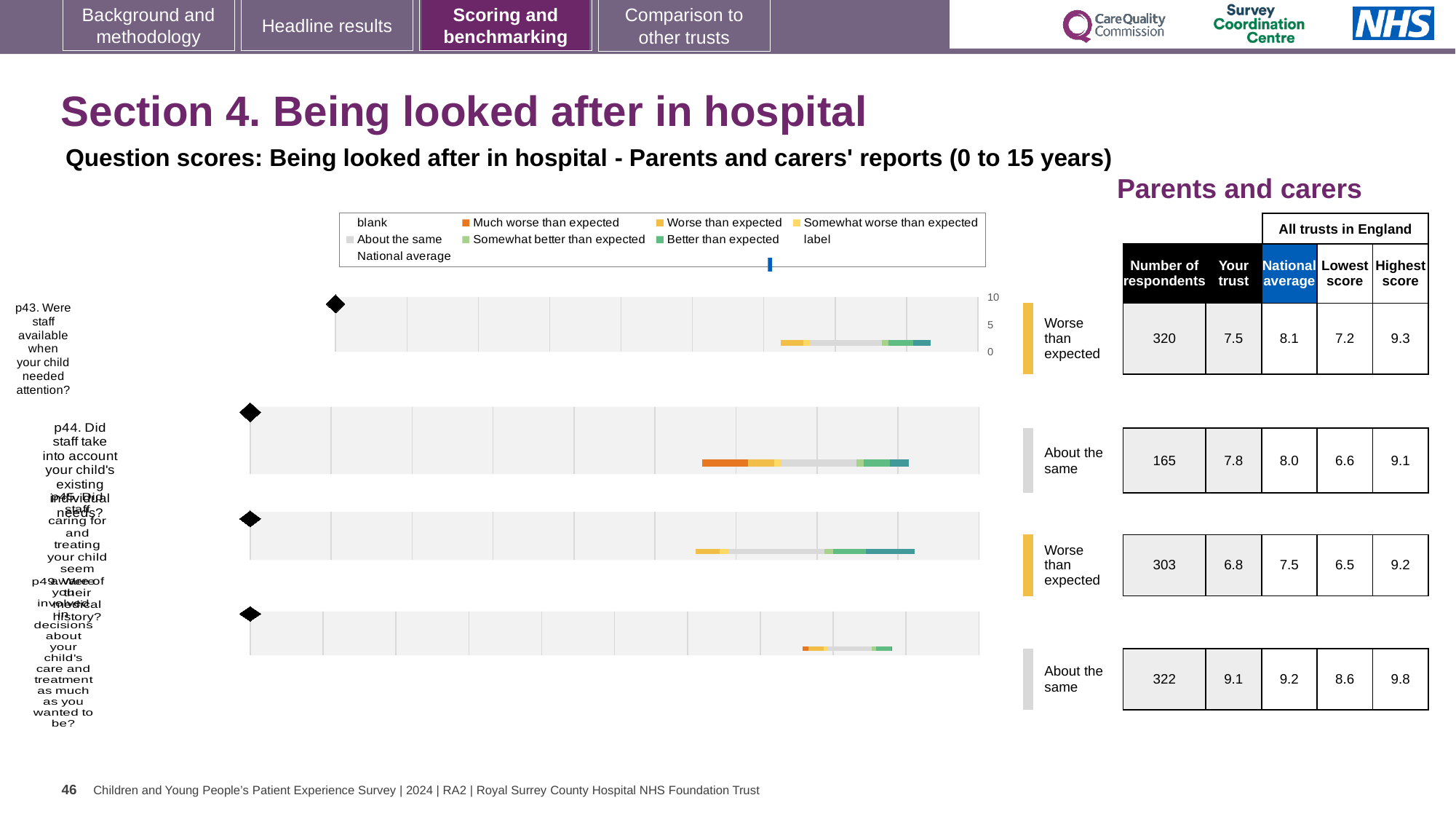
For the p45 chart (Did staff caring for and treating your child seem aware of their medical history?), what is the lowest score among all trusts in England? 6.5 Which question row has the highest 'Your trust' score? p49. Were you involved in decisions about your child's care and treatment as much as you wanted to be? In the legend, what colour represents 'Much worse than expected'? Orange For the p49 chart (Were you involved in decisions about your child's care and treatment as much as you wanted to be?), what is the 'Your trust' score? 9.1 For the p43 chart, is the 'Your trust' score or the national average larger? National average Which question row has the lowest 'Your trust' score? p45. Did staff caring for and treating your child seem aware of their medical history? For the p43 chart (Were staff available when your child needed attention?), what is the 'Your trust' score shown in the table? 7.5 For the p45 chart, what is the difference between the national average and the 'Your trust' score? 0.7 For the p43 chart (Were staff available when your child needed attention?), what is the national average shown in the table? 8.1 How many question rows (charts) are shown on the slide? 4 What kind of chart is used for the p43 question row (Were staff available when your child needed attention)? bar chart For the p44 chart (Did staff take into account your child's existing individual needs?), how many respondents are listed? 165